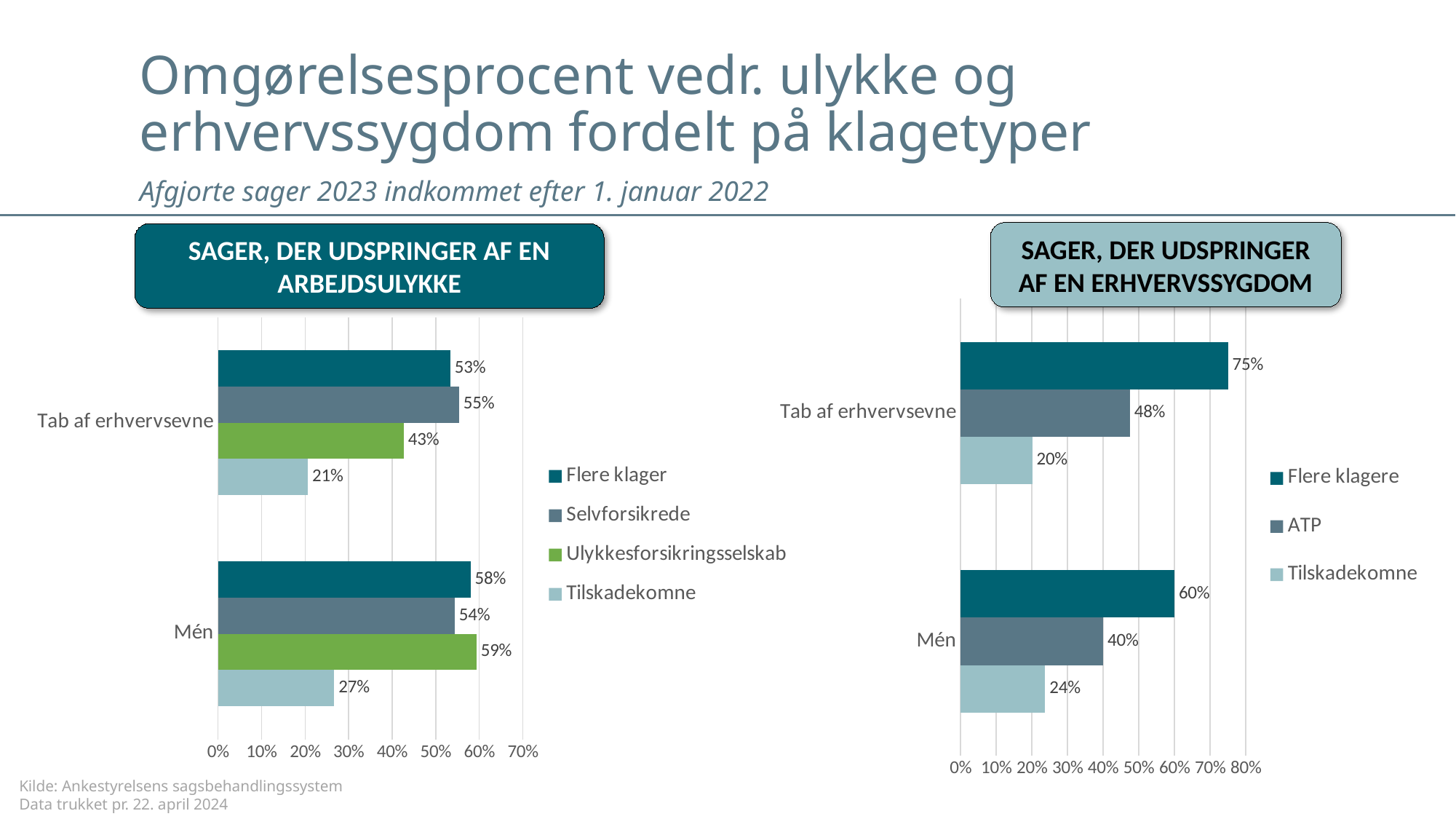
In the chart 'Sager, der udspringer af en arbejdsulykke', what is the difference between Selvforsikrede and Tilskadekomne under Mén? 27% In the chart 'Sager, der udspringer af en arbejdsulykke', what is the value for Tilskadekomne under Mén? 27% In the chart 'Sager, der udspringer af en arbejdsulykke', what is the value for Ulykkesforsikringsselskab under Tab af erhvervsevne? 43% How many series does the legend of the chart 'Sager, der udspringer af en arbejdsulykke' list? 4 In the chart 'Sager, der udspringer af en erhvervssygdom', which series has the highest value under Tab af erhvervsevne? Flere klagere What kind of chart is 'Sager, der udspringer af en erhvervssygdom'? Bar chart In the chart 'Sager, der udspringer af en erhvervssygdom', what is the value for ATP under Mén? 40% In the chart 'Sager, der udspringer af en arbejdsulykke', which is larger under Tab af erhvervsevne: Flere klager or Ulykkesforsikringsselskab? Flere klager How many series does the legend of the chart 'Sager, der udspringer af en erhvervssygdom' list? 3 In the chart 'Sager, der udspringer af en arbejdsulykke', which series has the lowest value under Tab af erhvervsevne? Tilskadekomne In the chart 'Sager, der udspringer af en erhvervssygdom', what is the difference between Flere klagere and ATP under Tab af erhvervsevne? 27% In the chart 'Sager, der udspringer af en erhvervssygdom', what is the value for Flere klagere under Tab af erhvervsevne? 75%